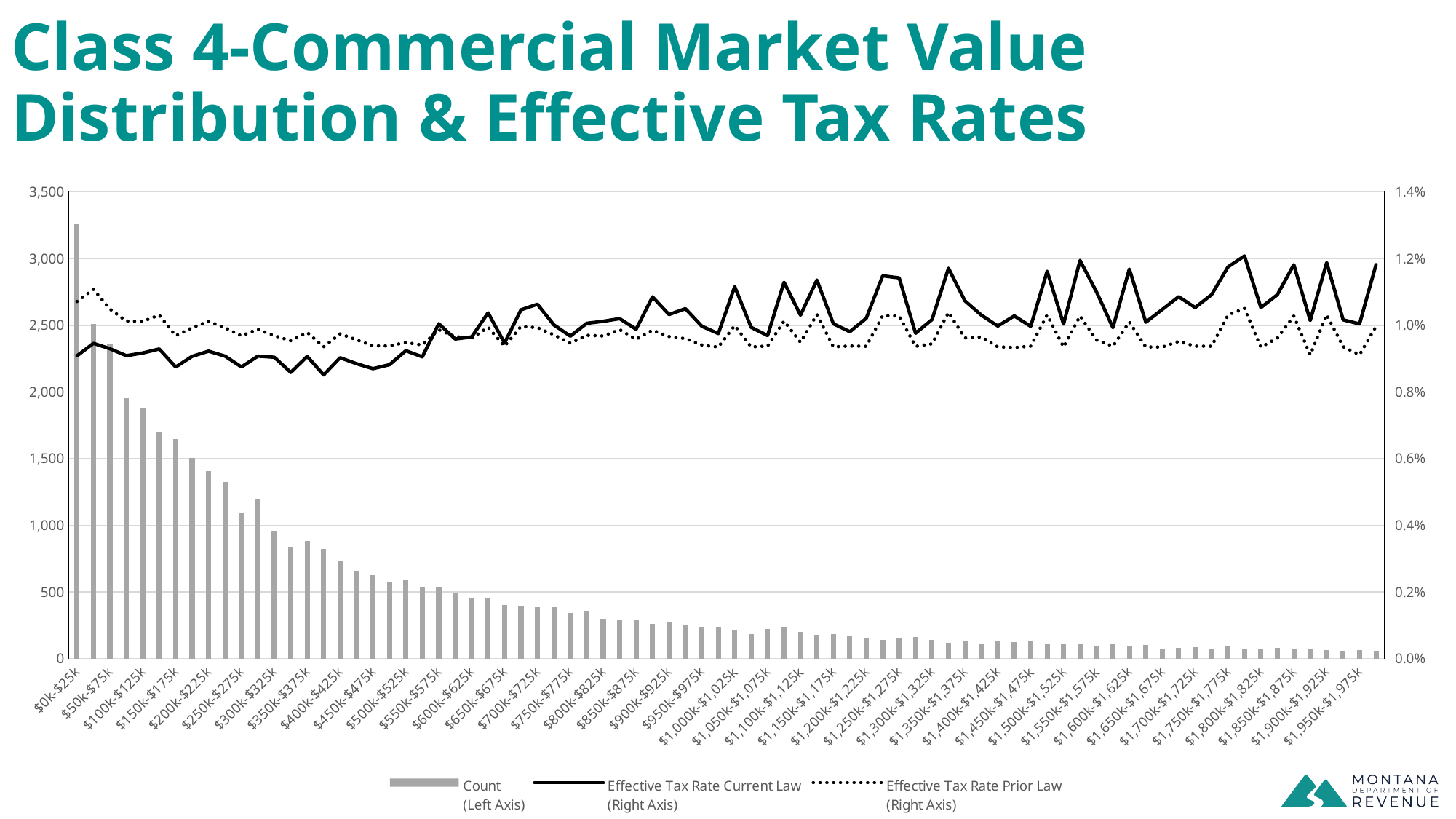
Is the Count for $200k-$225k greater or less than 1,500? less Do the Count bars generally rise or fall as market value increases along the x axis? fall Is the Count for $400k-$425k greater or less than 500? greater How many series does the legend list? 3 At $0k-$25k, which is larger: the Effective Tax Rate Current Law or the Effective Tax Rate Prior Law? Effective Tax Rate Prior Law Which market value range has the highest Count? $0k-$25k Is the Count for $100k-$125k greater or less than 2,000? less At $1,950k-$1,975k, which is larger: the Effective Tax Rate Current Law or the Effective Tax Rate Prior Law? Effective Tax Rate Current Law Which series is plotted on the left axis according to the legend? Count What kind of chart is shown on the slide? A combination bar and line chart